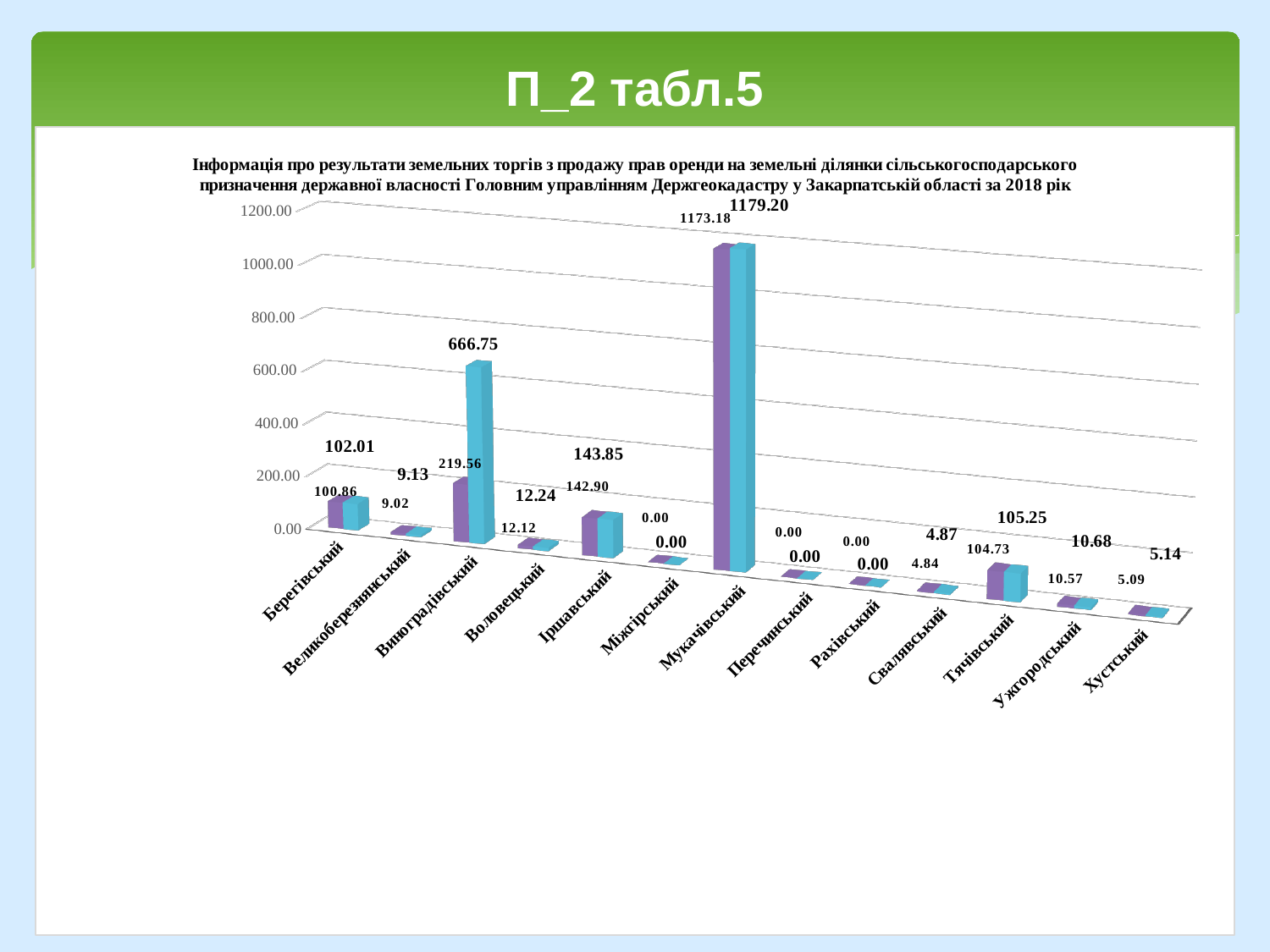
What kind of chart is shown on the slide? bar chart Which district has the highest values in the chart? Мукачівський What is the value of the purple (first) bar for Виноградівський? 219.56 What is the value of the blue (second) bar for Виноградівський? 666.75 What is the value of the purple (first) bar for Хустський? 5.09 Is the value for Мукачівський greater or less than 1000.00? greater How many districts (categories) are shown along the x axis? 13 What is the difference between the blue bar (1179.20) and the purple bar (1173.18) for Мукачівський? 6.02 How many bars are plotted for each district? 2 What is the difference between the blue bar and the purple bar for Виноградівський? 447.19 What is the value of the blue (second) bar for Тячівський? 105.25 Which has the larger blue-bar value, Берегівський or Тячівський? Тячівський